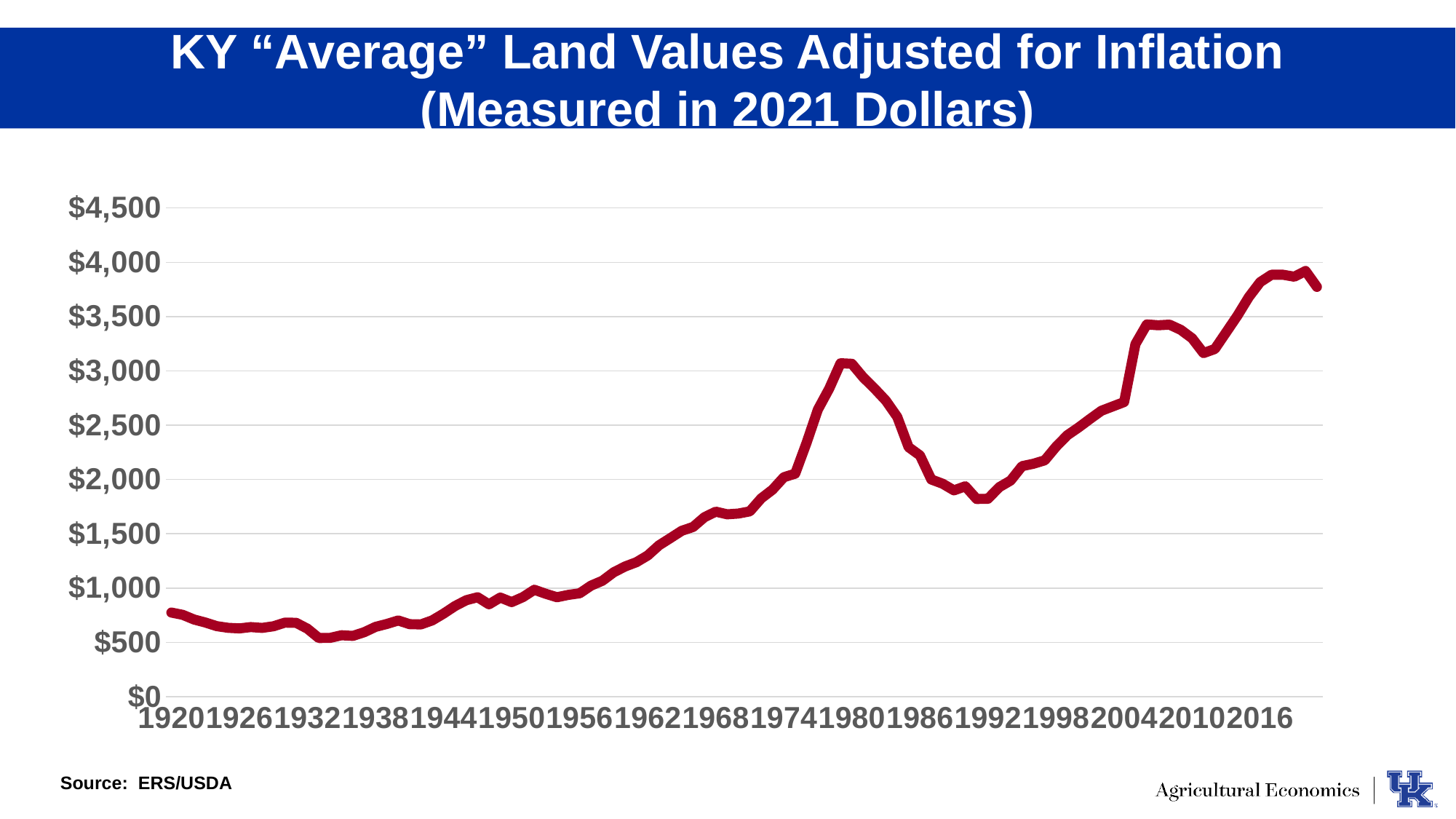
Which year has the higher land value, 1920 or 1932? 1920 Is the value for 2016 greater or less than $3,500? greater What source is cited for the chart data? ERS/USDA Is the value for 2004 greater or less than $3,000? less Is the value for 1920 greater or less than $1,000? less What kind of chart is shown on the slide? line chart What is the title of the chart? KY “Average” Land Values Adjusted for Inflation (Measured in 2021 Dollars) Do land values rise or fall between 1980 and 1992? fall Which year has the higher land value, 1980 or 1992? 1980